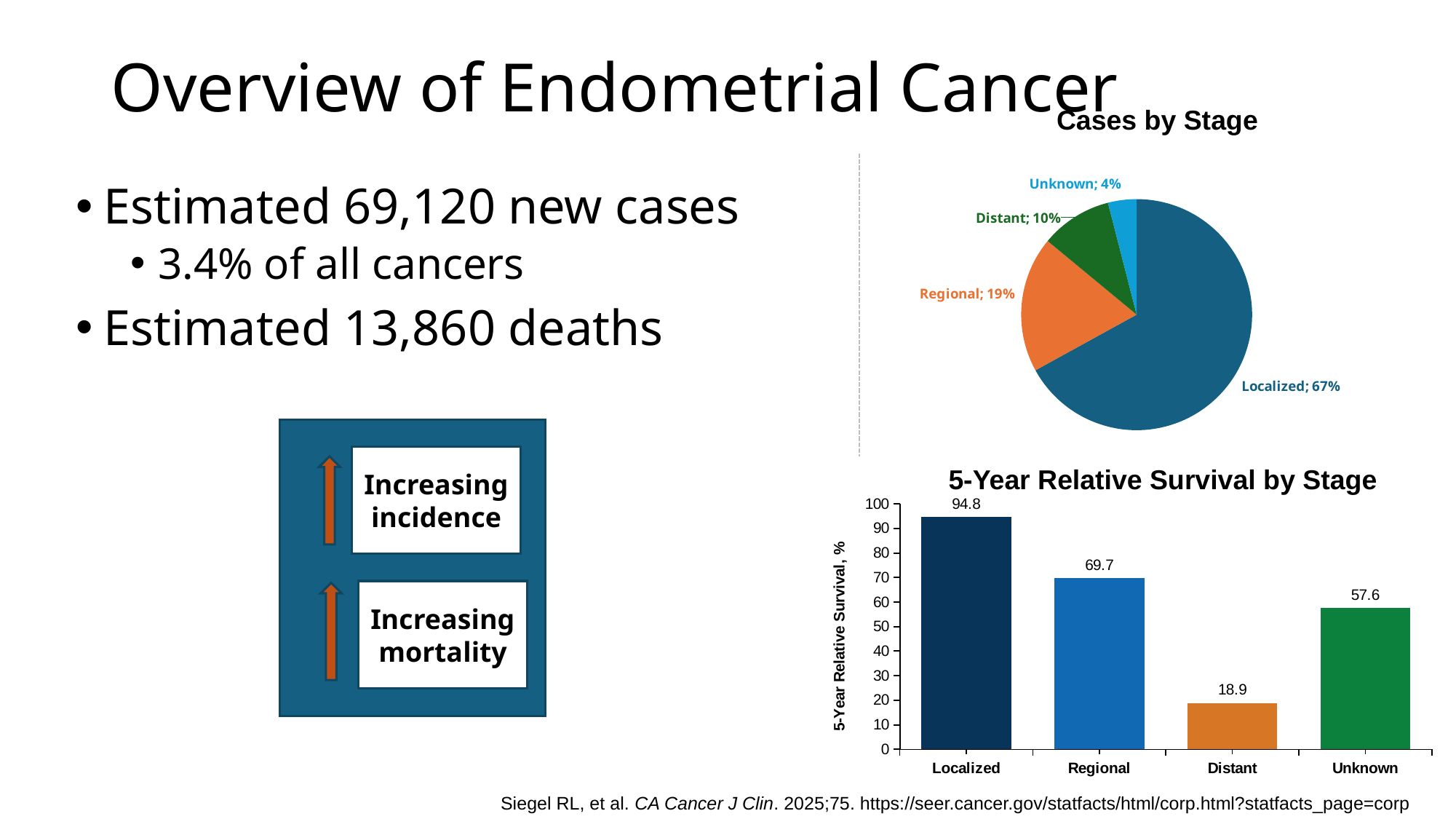
What kind of chart is '5-Year Relative Survival by Stage'? Bar chart In the 'Cases by Stage' chart, how many slices does the pie have? 4 In the 'Cases by Stage' chart, which stage has the smallest slice? Unknown In the 'Cases by Stage' chart, what share of cases is Regional? 19% In the '5-Year Relative Survival by Stage' chart, what is the value for Regional? 69.7 What kind of chart is 'Cases by Stage'? Pie chart In the '5-Year Relative Survival by Stage' chart, which is larger, Regional or Unknown? Regional In the '5-Year Relative Survival by Stage' chart, which stage has the lowest survival? Distant In the 'Cases by Stage' chart, what share of cases is Localized? 67% In the '5-Year Relative Survival by Stage' chart, what is the value for Distant? 18.9 In the '5-Year Relative Survival by Stage' chart, which stage has the highest survival? Localized In the '5-Year Relative Survival by Stage' chart, what is the difference between Localized and Unknown? 37.2